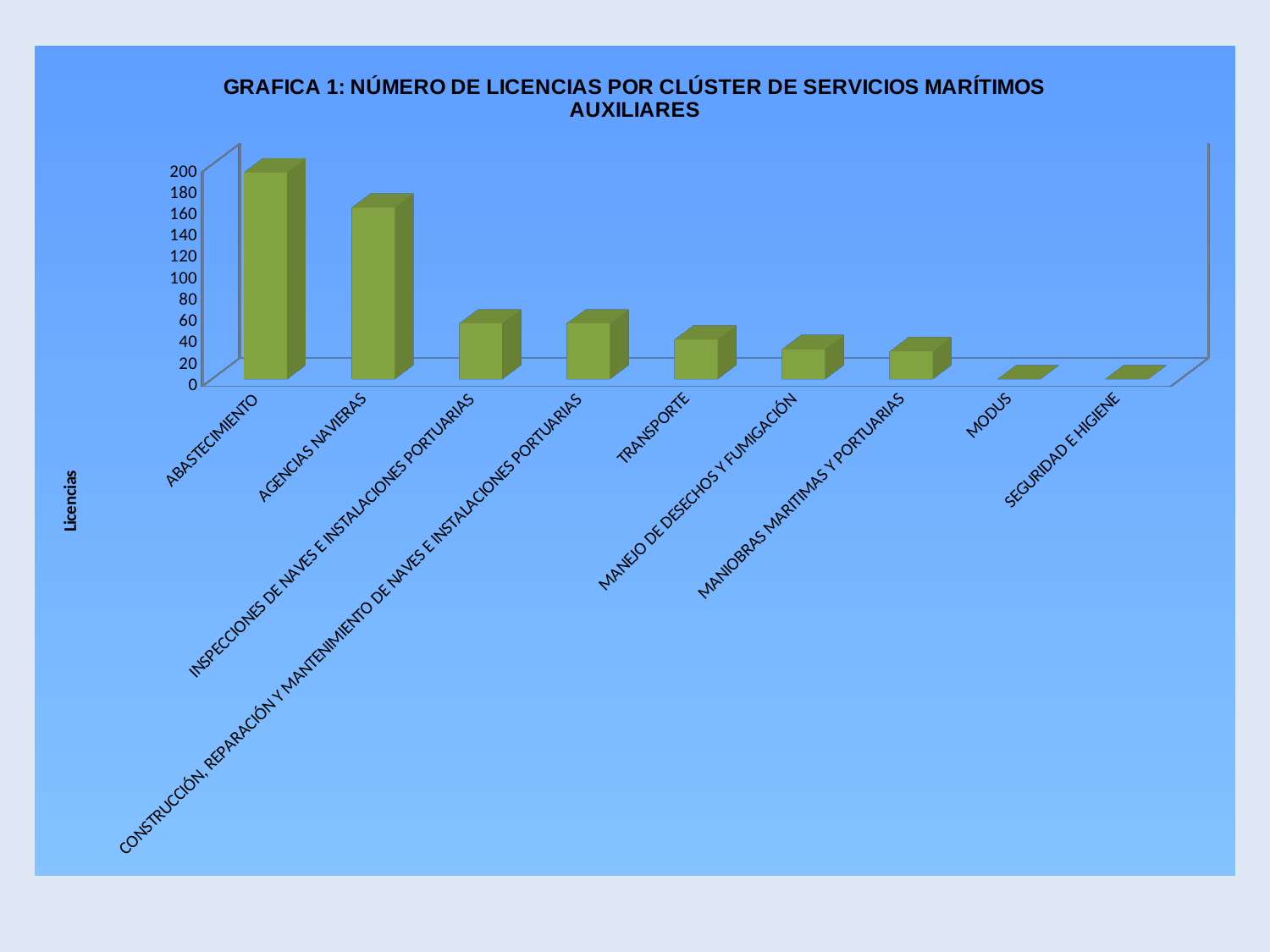
What is the title of the chart? GRAFICA 1: NÚMERO DE LICENCIAS POR CLÚSTER DE SERVICIOS MARÍTIMOS AUXILIARES Is the value for ABASTECIMIENTO greater or less than 140? greater Which category has the highest number of licencias? ABASTECIMIENTO Do the values generally rise or fall moving from left to right along the x axis? Fall Which is larger, the value for AGENCIAS NAVIERAS or the value for TRANSPORTE? AGENCIAS NAVIERAS How many categories are shown on the x axis of the chart? 9 What type of chart is shown on the slide? Bar chart Is the value for AGENCIAS NAVIERAS greater or less than 100? greater Which is larger, the value for ABASTECIMIENTO or the value for AGENCIAS NAVIERAS? ABASTECIMIENTO Is the value for TRANSPORTE greater or less than 100? less What is the label of the vertical axis? Licencias